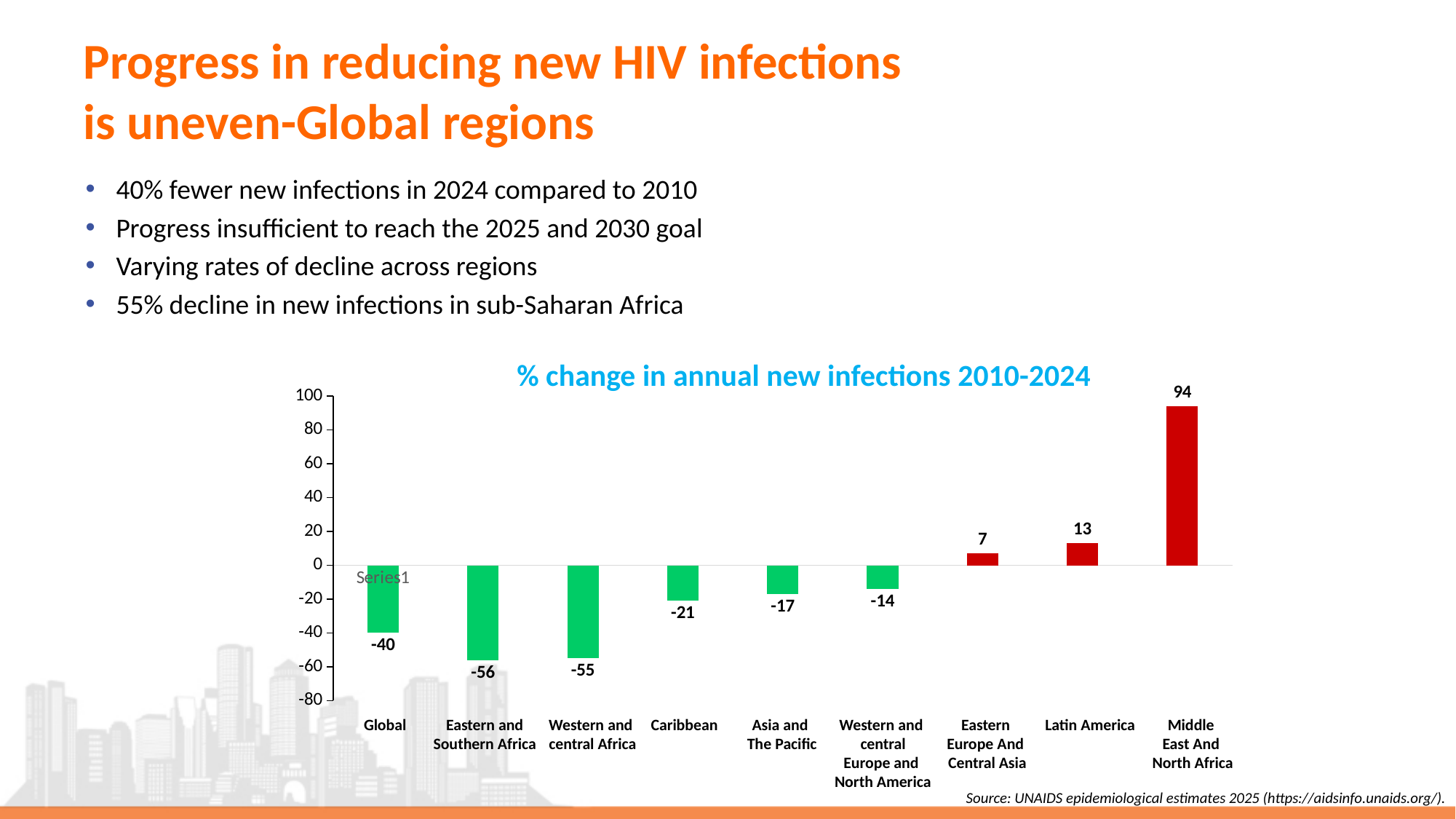
What is the difference between the values for Latin America and Eastern Europe And Central Asia? 6 What colour are the bars with negative values? Green Which has a larger value, Caribbean or Asia and The Pacific? Asia and The Pacific What is the title of the chart? % change in annual new infections 2010-2024 Which region has the highest value in the chart? Middle East And North Africa How many regions (categories) are shown in the chart? 9 Which region has the lowest value in the chart? Eastern and Southern Africa What is the value for Western and central Europe and North America? -14 What is the value for Middle East And North Africa? 94 What is the value for Global in the chart? -40 What kind of chart is shown on the slide? Bar chart What is the % change in annual new infections for Eastern and Southern Africa? -56